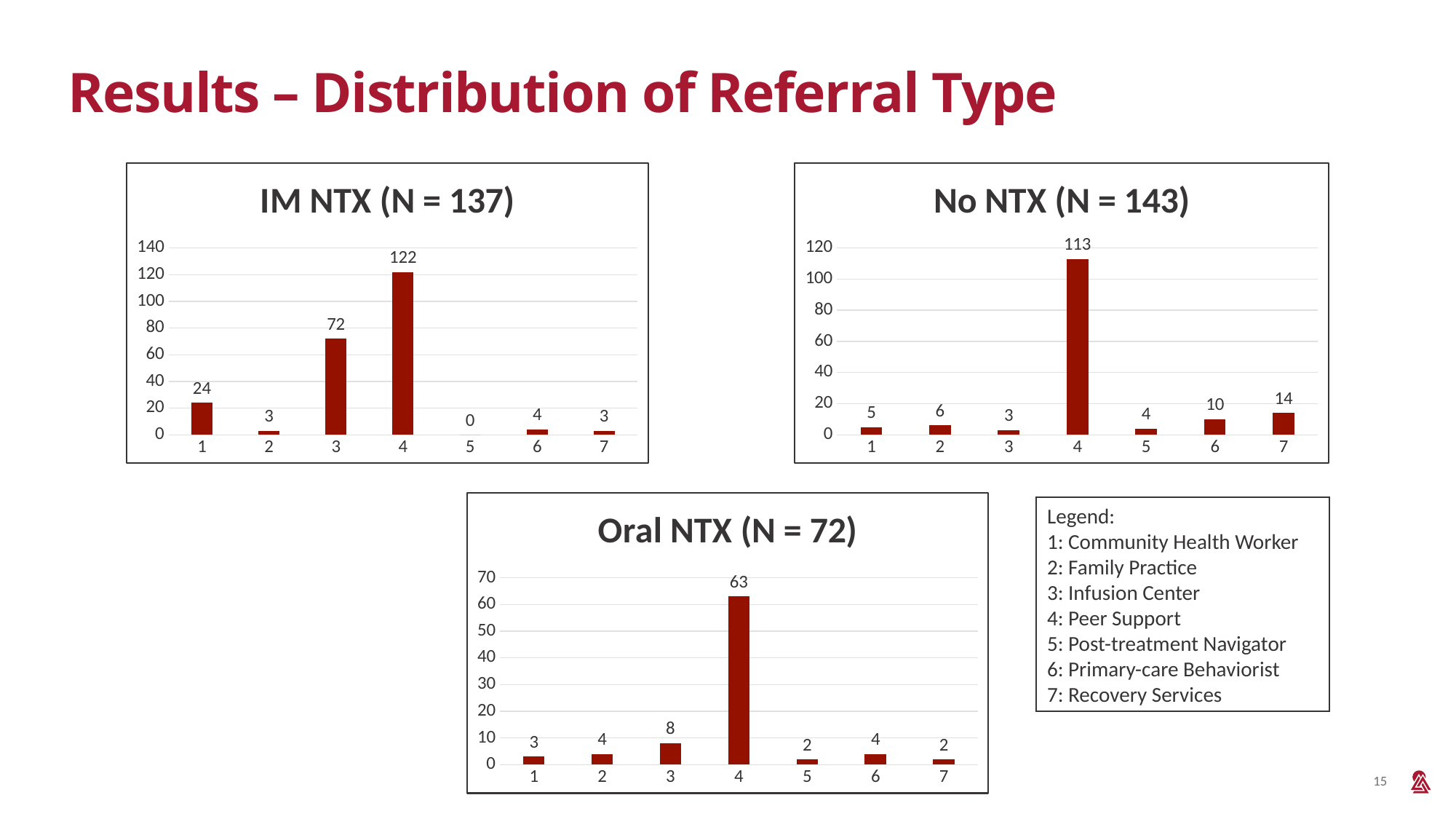
In the No NTX (N = 143) chart, what is the value for category 7? 14 In the IM NTX (N = 137) chart, what is the difference between the values for category 4 and category 3? 50 In the No NTX (N = 143) chart, is the value for category 4 greater or less than 100? greater In the No NTX (N = 143) chart, which category has the highest value? 4 In the IM NTX (N = 137) chart, what is the value for category 3? 72 How many categories are shown on the x axis of the Oral NTX (N = 72) chart? 7 In the No NTX (N = 143) chart, what is the difference between the values for category 7 and category 6? 4 What kind of chart is the IM NTX (N = 137) chart? bar chart In the IM NTX (N = 137) chart, which category has the highest value? 4 In the Oral NTX (N = 72) chart, which is larger, the value for category 3 or the value for category 6? category 3 In the IM NTX (N = 137) chart, which category has the lowest value? 5 In the Oral NTX (N = 72) chart, what is the value for category 3? 8